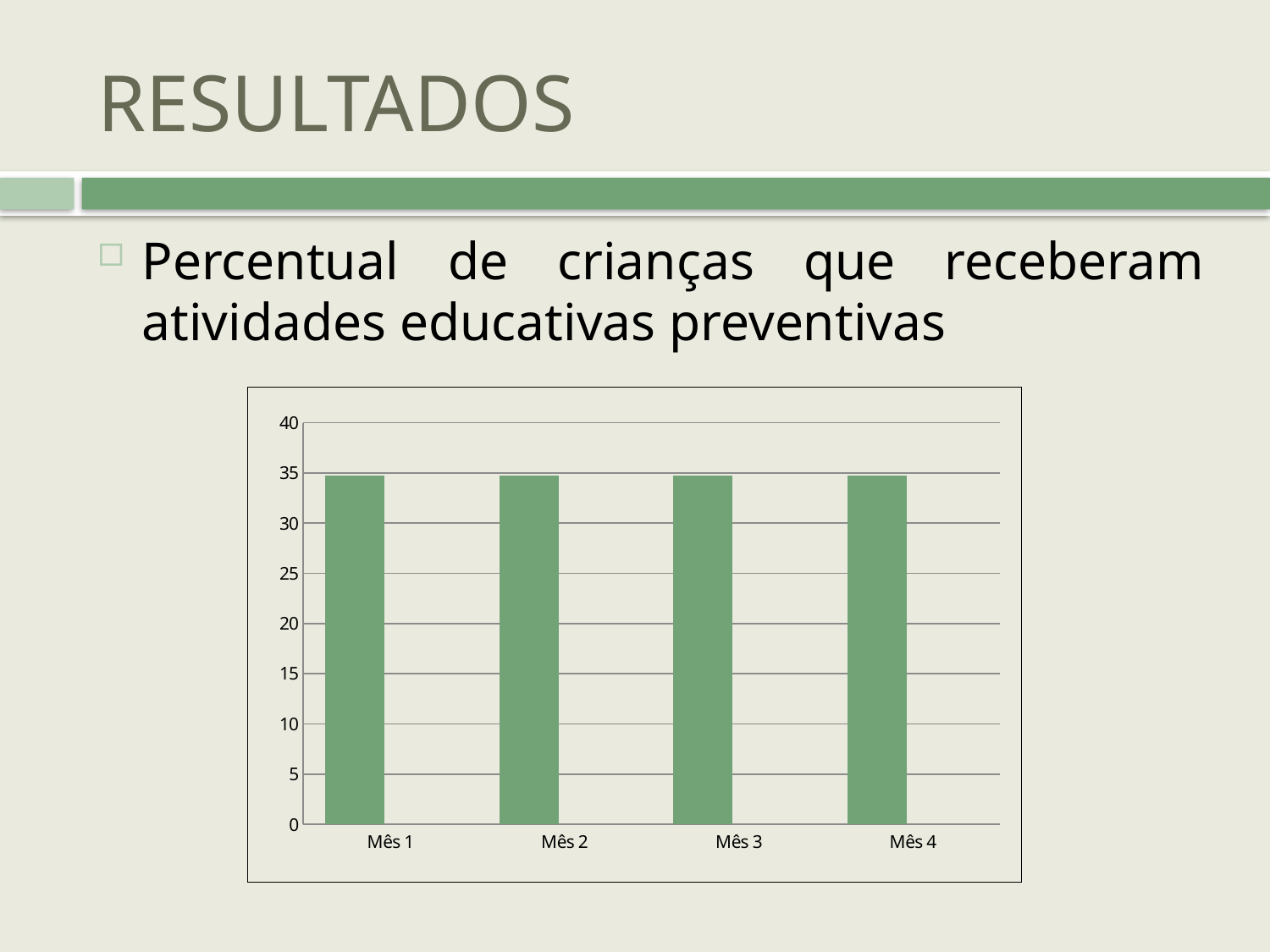
Is the value for Mês 3 greater or less than 25? greater Is the value for Mês 4 greater or less than 40? less Do the values rise, fall, or stay roughly flat from Mês 1 to Mês 4? stay roughly flat What kind of chart is shown on the slide? bar chart What is the highest tick value shown on the y axis? 40 Is the value for Mês 2 greater or less than 40? less What is the label of the first category on the x axis? Mês 1 How many categories are plotted on the x axis of the chart? 4